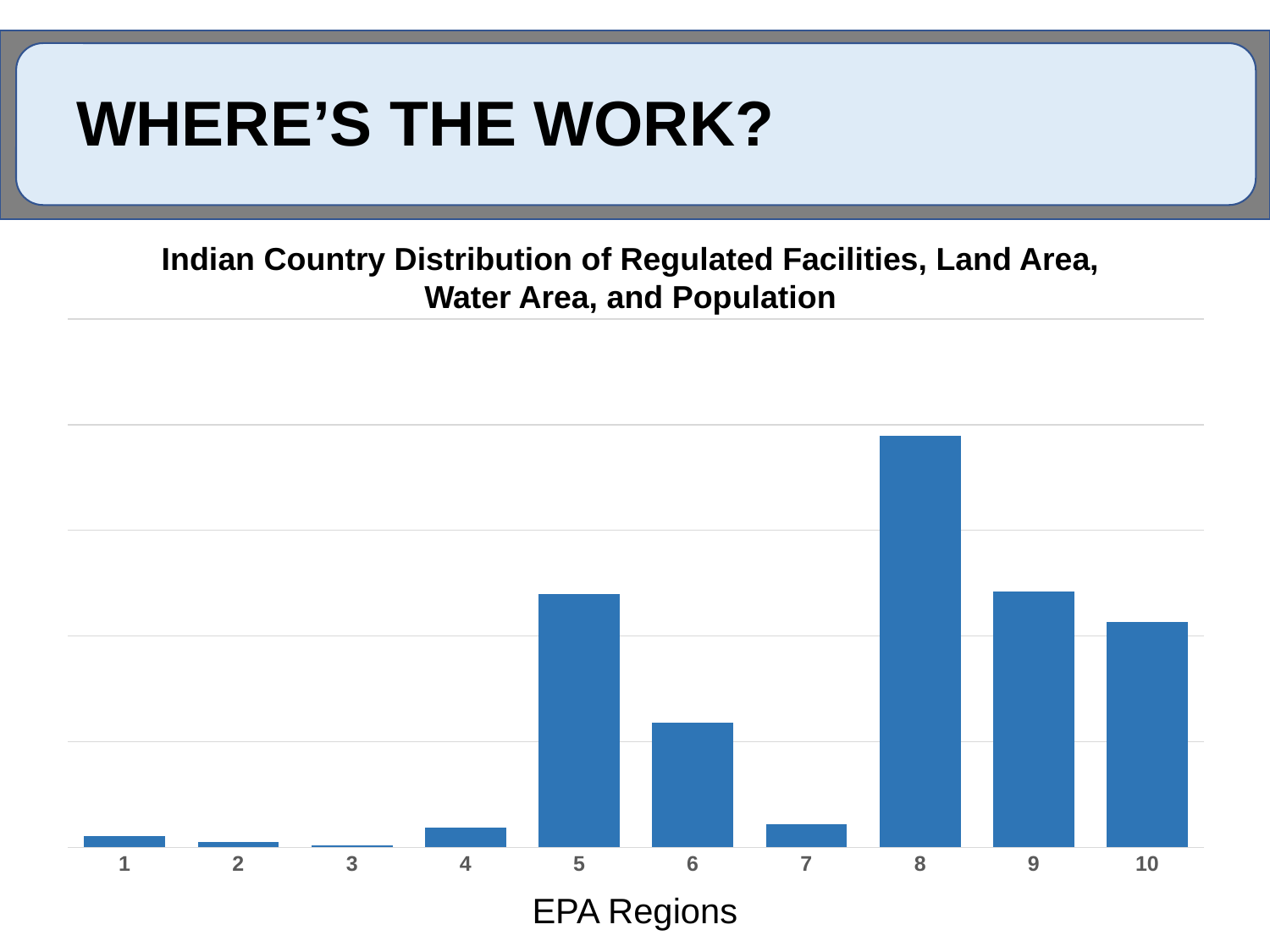
What kind of chart is shown on the slide? Bar chart How many EPA regions are shown on the x axis of the chart? 10 Which EPA region has the lowest bar in the chart? 3 Which has the larger value, EPA region 8 or EPA region 9? 8 Which EPA region has the highest bar in the chart? 8 Which has the larger value, EPA region 6 or EPA region 7? 6 Which has the larger value, EPA region 1 or EPA region 2? 1 What is the title of the chart? Indian Country Distribution of Regulated Facilities, Land Area, Water Area, and Population What is the label of the x axis of the chart? EPA Regions